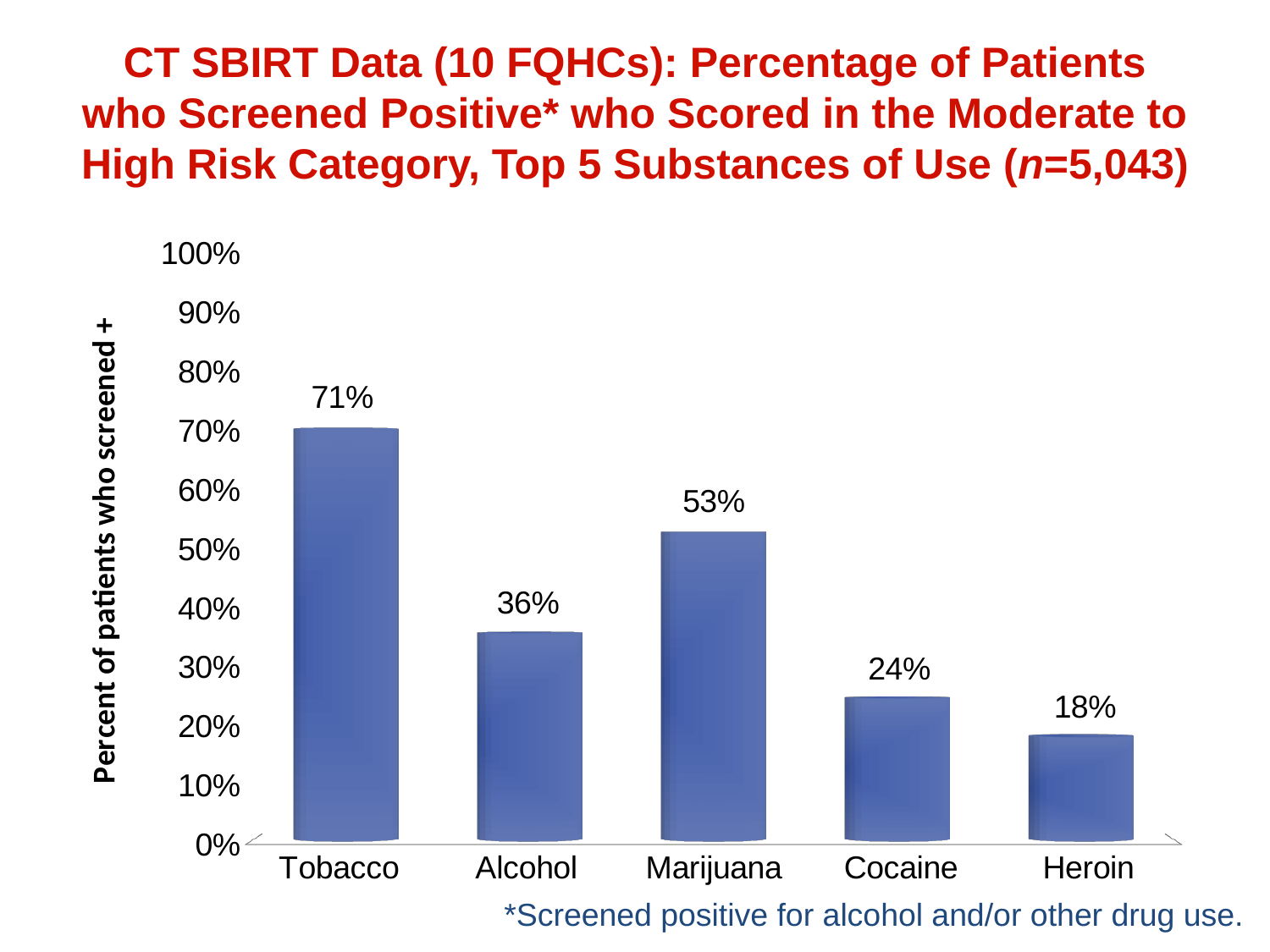
How many substances are shown on the chart? 5 What percentage of patients who screened positive for tobacco scored in the moderate to high risk category? 71% Is the value for Cocaine greater or less than 30%? less What is the value shown for Heroin? 18% What is the label of the vertical axis? Percent of patients who screened + What is the difference between the percentages for Cocaine and Heroin? 6% What is the value shown for Marijuana? 53% What is the difference between the percentages for Tobacco and Alcohol? 35% Which substance has the highest percentage of patients in the moderate to high risk category? Tobacco Which substance has the lowest percentage shown on the chart? Heroin What kind of chart is shown on the slide? Bar chart Which has a higher percentage, Alcohol or Marijuana? Marijuana